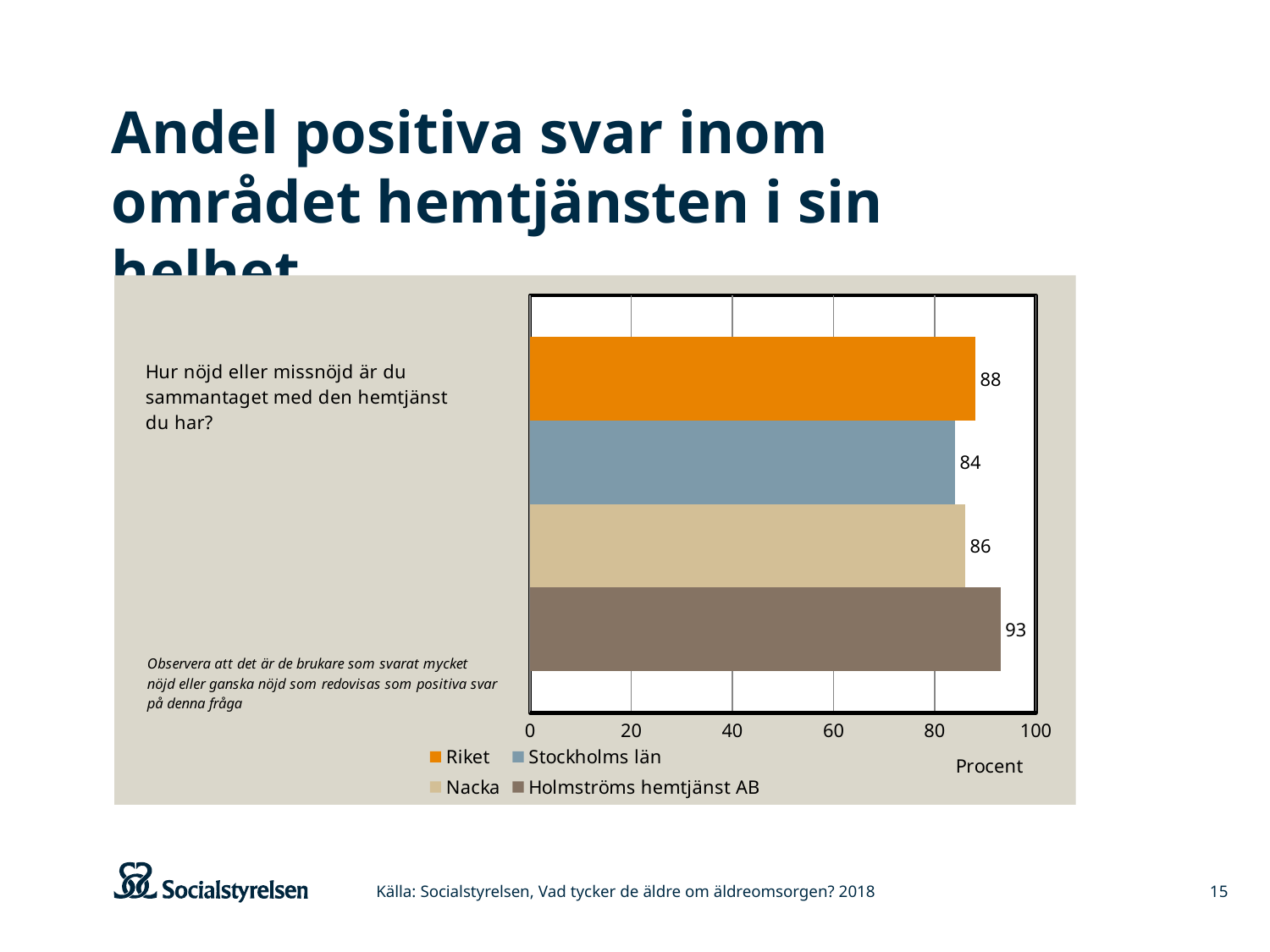
What is the difference between the values for Holmströms hemtjänst AB and Riket? 5 What is the value for Riket? 88 Which series has the highest value? Holmströms hemtjänst AB What is the label on the horizontal axis of the chart? Procent What is the value for Holmströms hemtjänst AB? 93 Which is larger, the value for Riket or the value for Nacka? Riket How many series does the legend list? 4 Which series has the lowest value? Stockholms län What is the value for Nacka? 86 What is the difference between the values for Nacka and Stockholms län? 2 What is the value for Stockholms län? 84 What kind of chart is shown on the slide? Bar chart